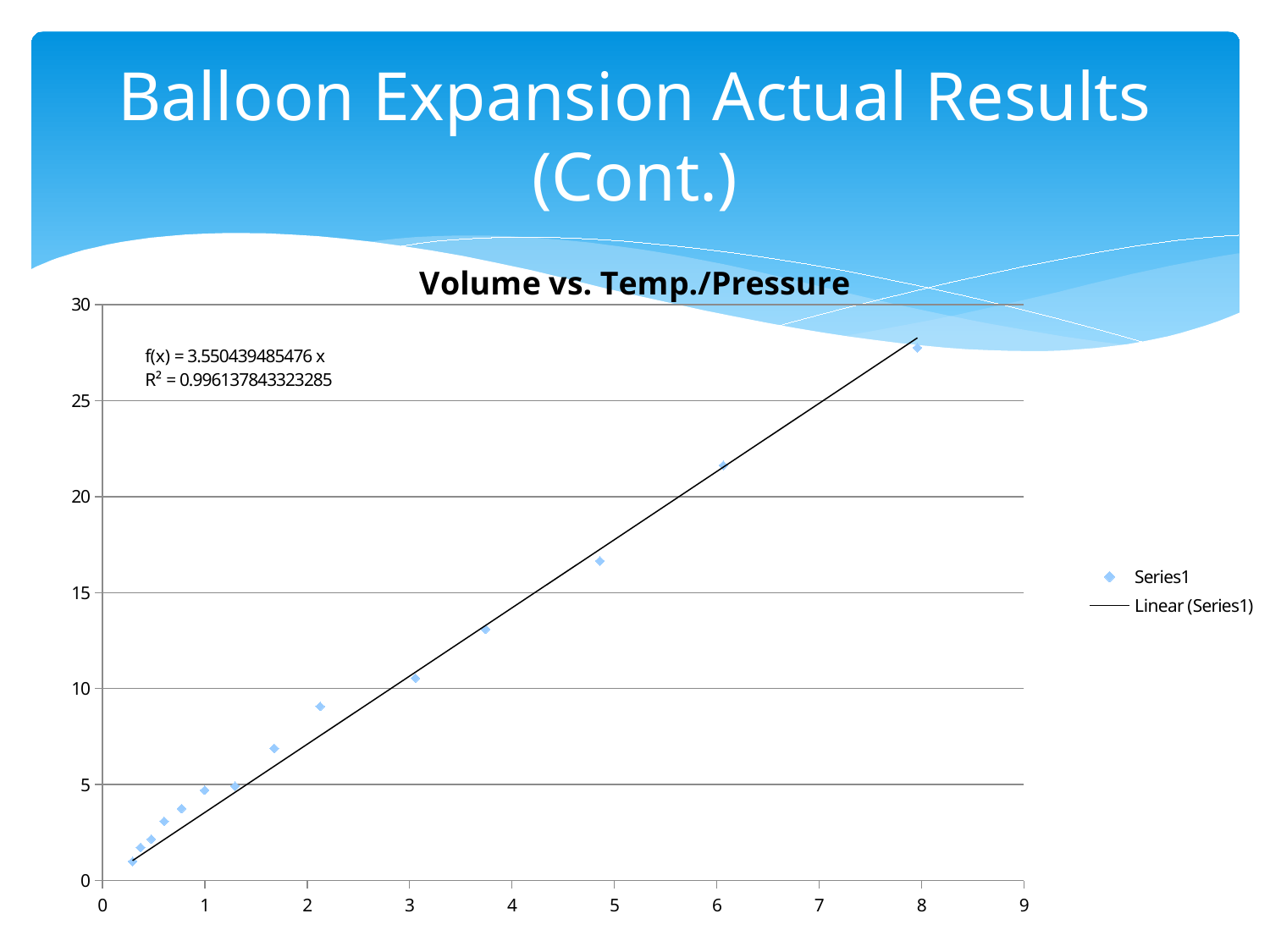
Is the value of the data point near x = 6 greater or less than 20? greater What is the title of the chart? Volume vs. Temp./Pressure Which data point has the highest y value: the one near x = 6 or the one near x = 8? The one near x = 8 How many entries does the chart legend list? 2 Is the value of the data point near x = 5 greater or less than 15? greater Do the plotted values rise or fall as the x value increases? Rise What kind of chart is shown on the slide? Scatter chart What is the maximum value shown on the y axis? 30 Is the value of the data point near x = 3 greater or less than 10? greater What is the equation of the trendline shown on the chart? f(x) = 3.550439485476 x